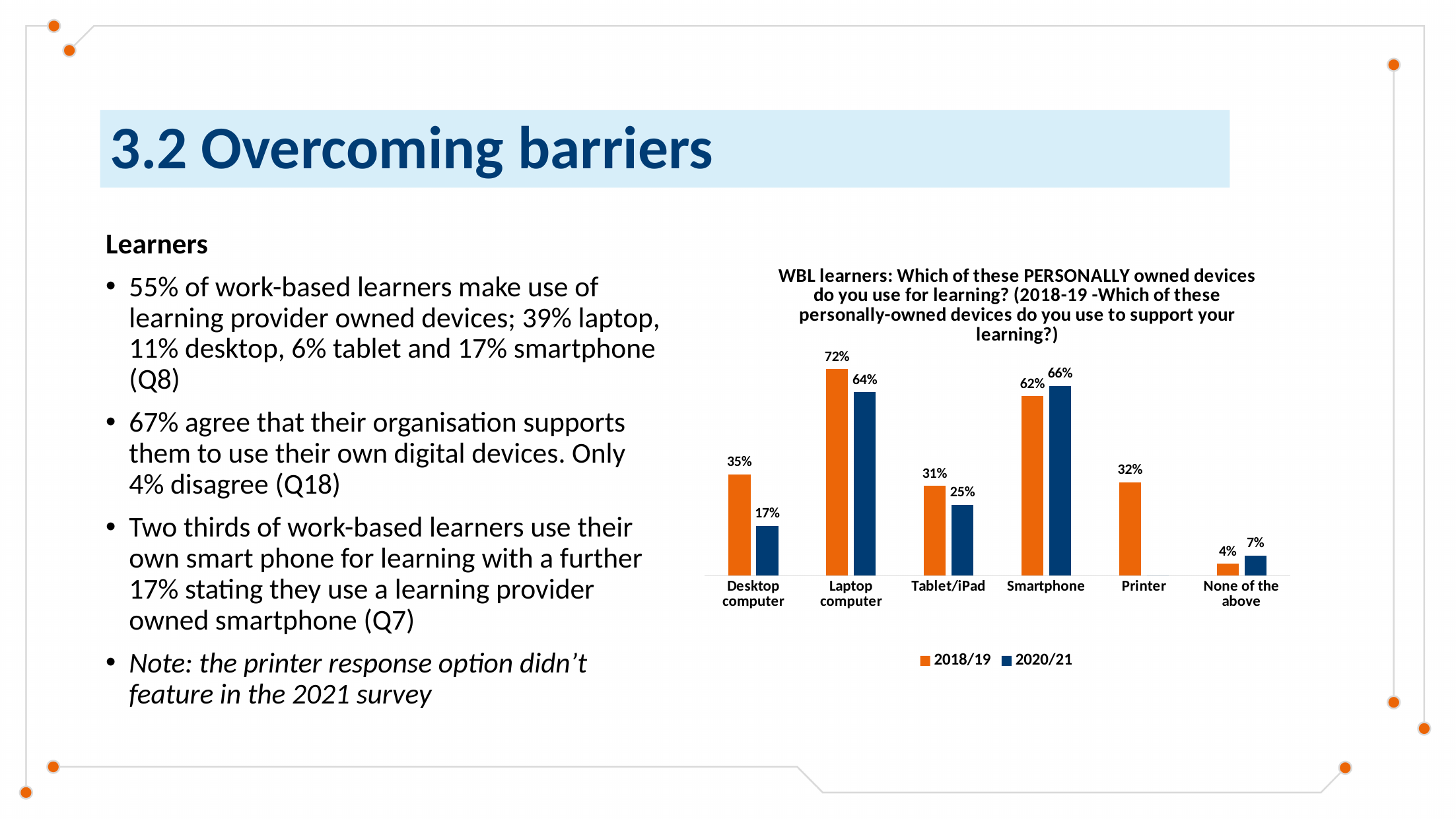
What kind of chart is shown on the slide? Bar chart What is the 2018/19 value for Printer? 32% Which category has the highest 2018/19 value? Laptop computer What is the difference between the 2018/19 and 2020/21 values for Tablet/iPad? 6% Which is larger for Smartphone: the 2018/19 value or the 2020/21 value? 2020/21 What is the 2018/19 value for Laptop computer? 72% What is the 2020/21 value for Desktop computer? 17% Which colour represents the 2020/21 series in the chart? Dark blue How many series does the legend list? 2 Which category has the lowest 2020/21 value? None of the above What is the 2020/21 value for Smartphone? 66% How many categories are shown on the x axis? 6